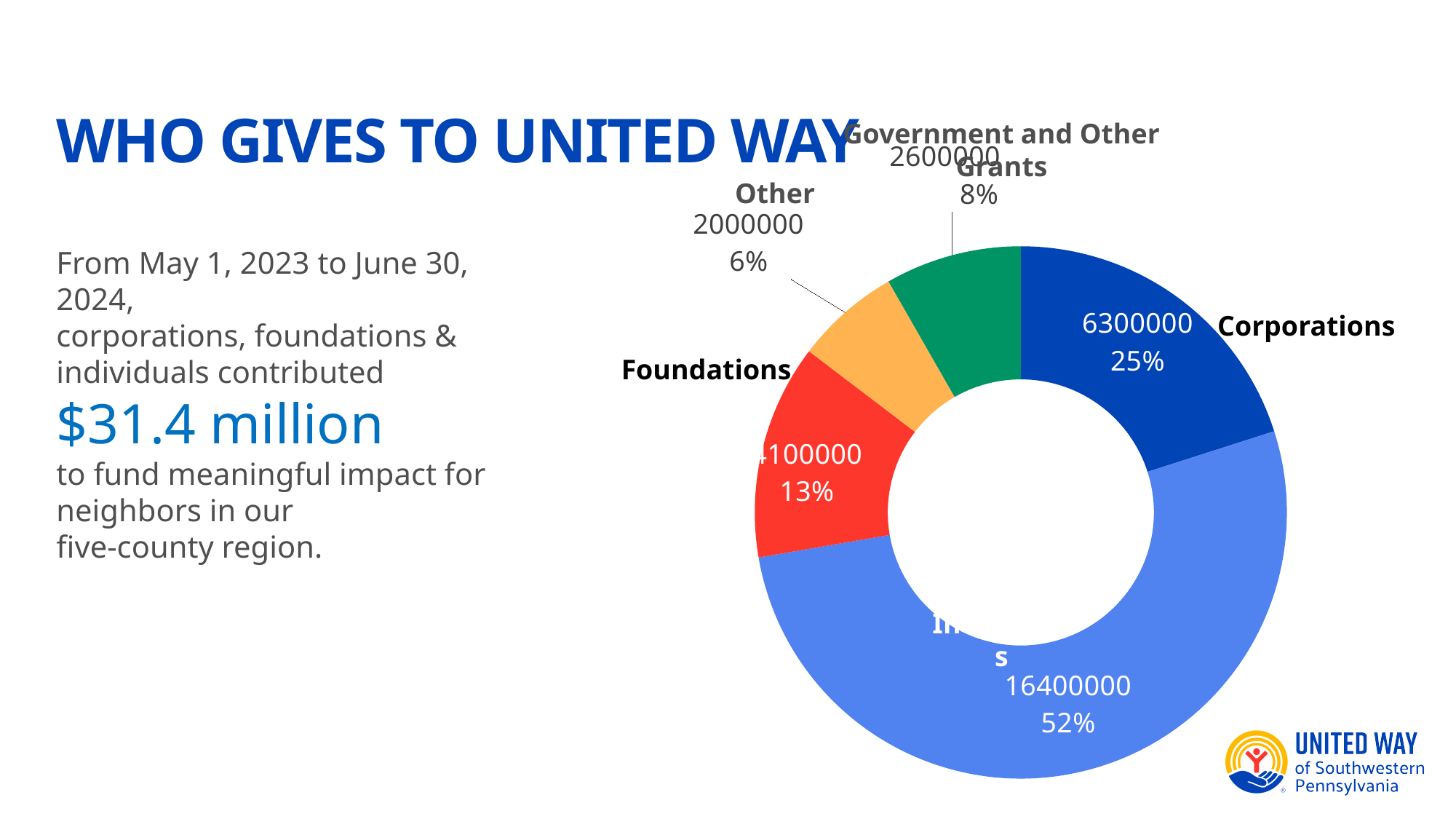
What value is shown for Other? 2000000 What value is shown for Corporations? 6300000 What percentage share does Government and Other Grants have? 8% Which category has the smallest share of the chart? Other What value is shown for Government and Other Grants? 2600000 What percentage share does Corporations have? 25% What type of chart is shown on the slide? Pie chart (donut) What is the difference between the value for Government and Other Grants and the value for Other? 600000 What is the percentage share of the largest slice in the chart? 52% What is the title of the slide containing the chart? WHO GIVES TO UNITED WAY Which is larger, the value for Corporations or the value for Government and Other Grants? Corporations